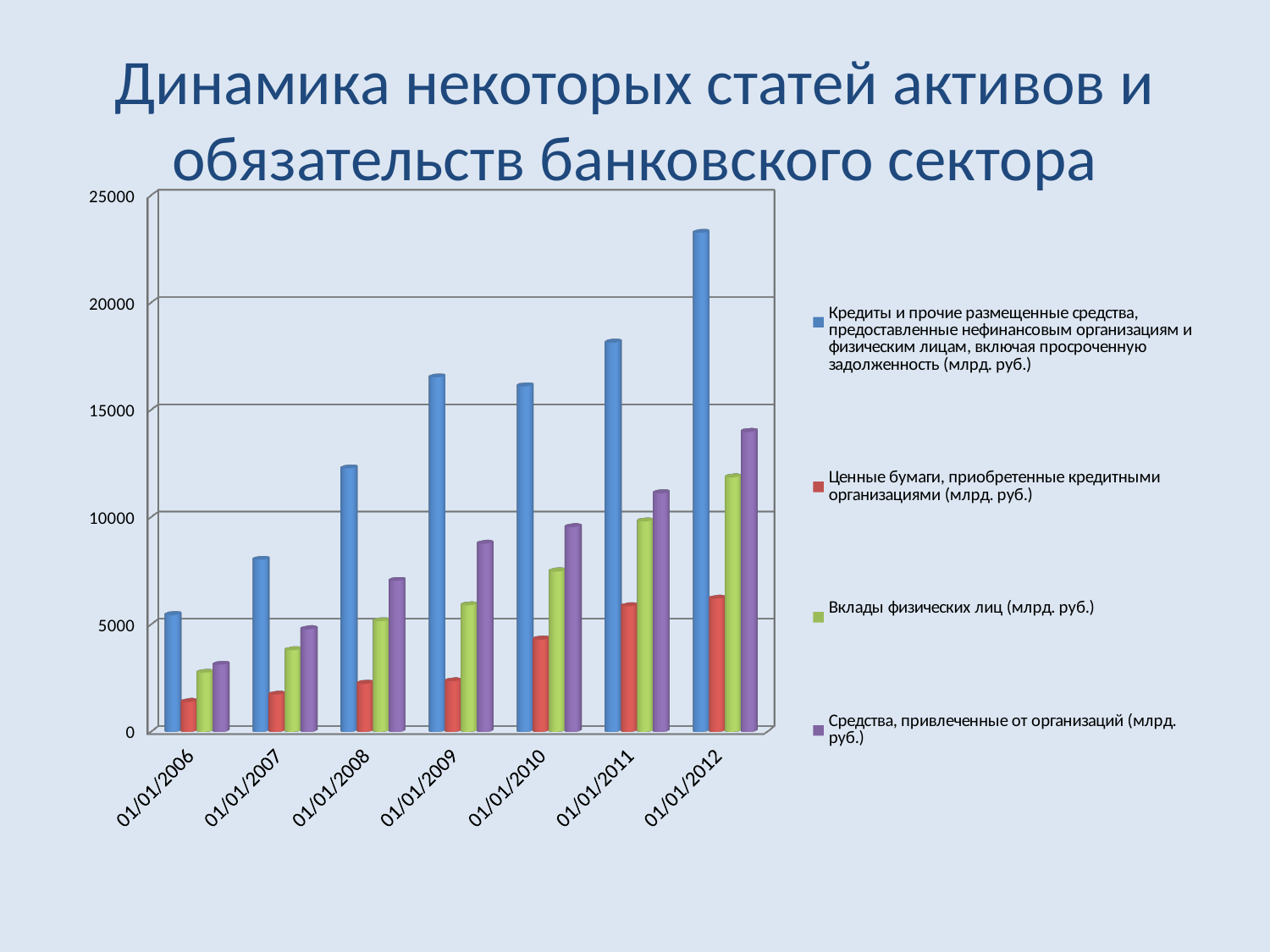
On which date is the value for 'Кредиты и прочие размещенные средства...' the highest? 01/01/2012 Do the values for 'Вклады физических лиц (млрд. руб.)' rise or fall from 01/01/2006 to 01/01/2012? Rise Is the value for 'Вклады физических лиц (млрд. руб.)' on 01/01/2012 greater or less than 10000? greater How many series does the legend list? 4 Is the value for 'Кредиты и прочие размещенные средства...' on 01/01/2012 greater or less than 20000? greater Is the value for 'Ценные бумаги, приобретенные кредитными организациями (млрд. руб.)' on 01/01/2010 greater or less than 5000? less On which date is the value for 'Кредиты и прочие размещенные средства...' the lowest? 01/01/2006 How many dates are shown along the x axis of the chart? 7 On 01/01/2011, which is larger: 'Вклады физических лиц (млрд. руб.)' or 'Средства, привлеченные от организаций (млрд. руб.)'? Средства, привлеченные от организаций (млрд. руб.) What colour represents 'Вклады физических лиц (млрд. руб.)' in the chart? Green What kind of chart is shown on the slide? Bar chart